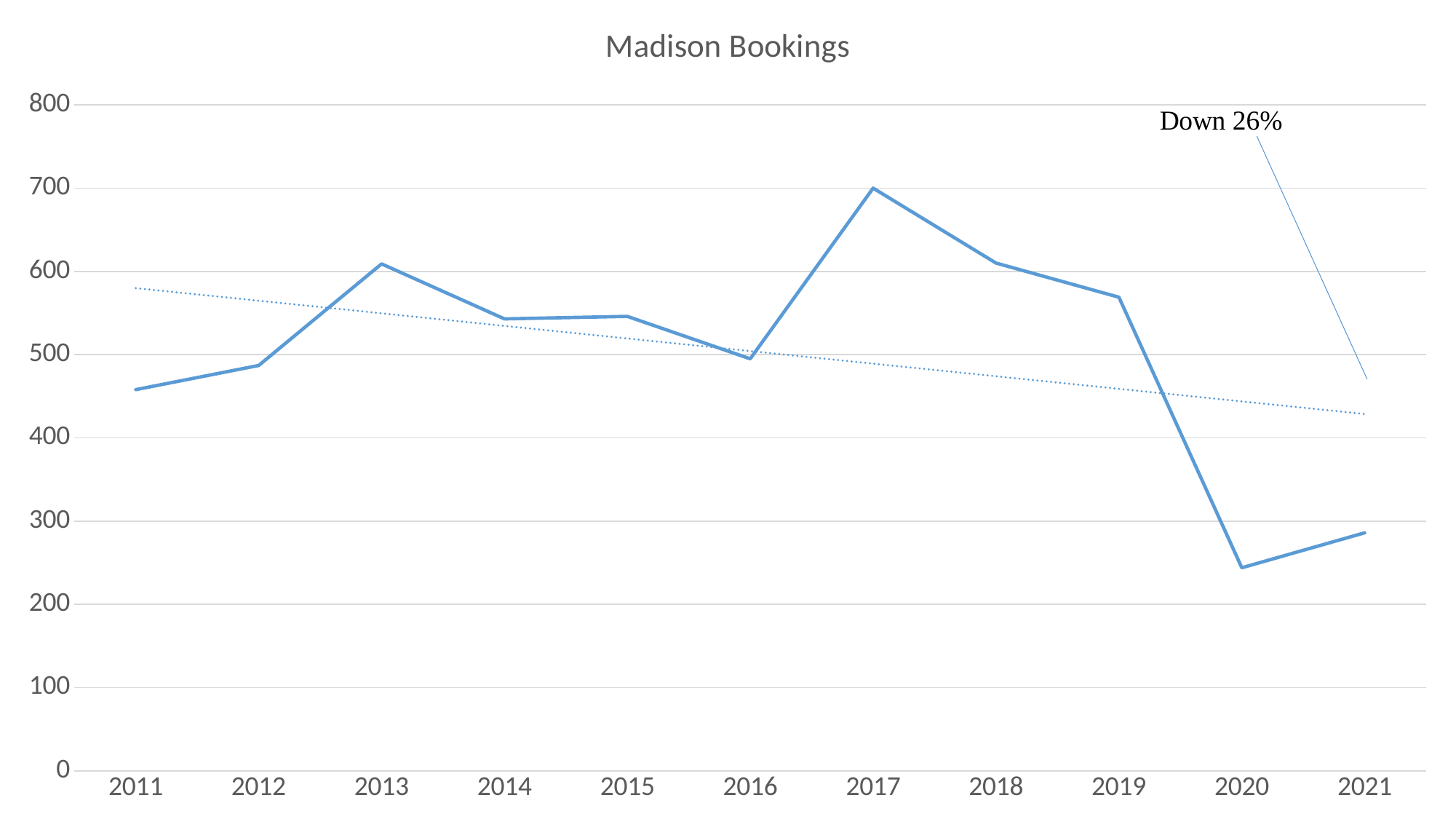
How many years are plotted on the x axis? 11 Is the value for 2017 greater or less than 600? greater Which year has the highest number of bookings? 2017 Which year has more bookings, 2013 or 2016? 2013 What kind of chart is shown on the slide? line chart Which year has more bookings, 2020 or 2021? 2021 Which year has the lowest number of bookings? 2020 Is the value for 2011 greater or less than 500? less What is the title of the chart? Madison Bookings What does the text annotation on the chart say? Down 26% Is the value for 2020 greater or less than 300? less